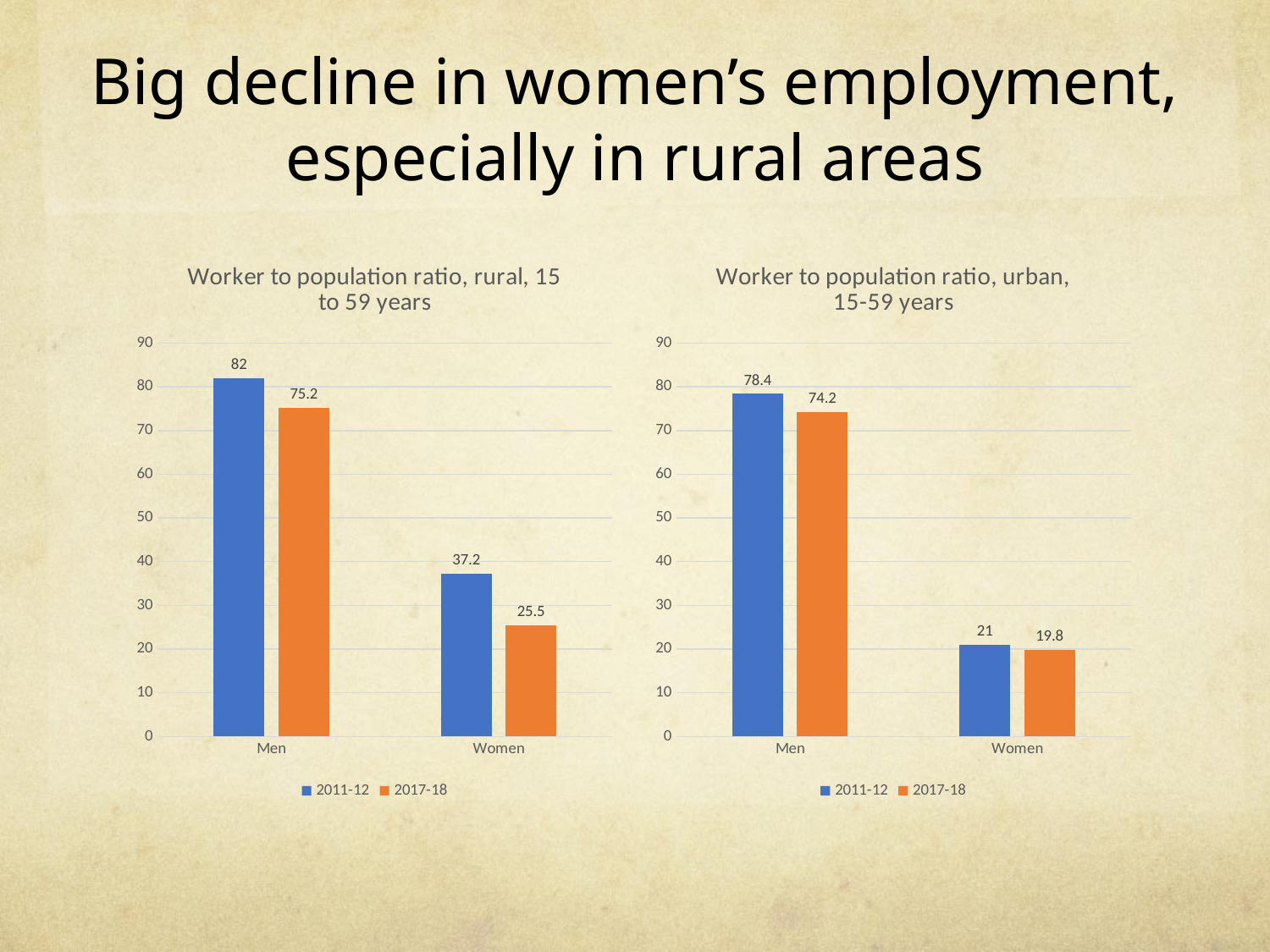
In the rural chart, what is the worker to population ratio for Men in 2011-12? 82 In the urban chart, what is the worker to population ratio for Men in 2017-18? 74.2 Which is larger: the rural Women value for 2011-12 or the urban Women value for 2011-12? Rural Women 2011-12 In the urban chart, what is the difference between the Men and Women values for 2011-12? 57.4 In the rural chart, what is the worker to population ratio for Women in 2017-18? 25.5 In the rural chart, by how much did the ratio for Women fall from 2011-12 to 2017-18? 11.7 What is the title of the chart on the left? Worker to population ratio, rural, 15 to 59 years In the rural chart, which bar is the lowest? Women, 2017-18 How many series does the legend of the rural chart list? 2 What type of chart is the urban chart? Bar chart In the urban chart, which bar is the highest? Men, 2011-12 In the urban chart, what is the worker to population ratio for Women in 2011-12? 21